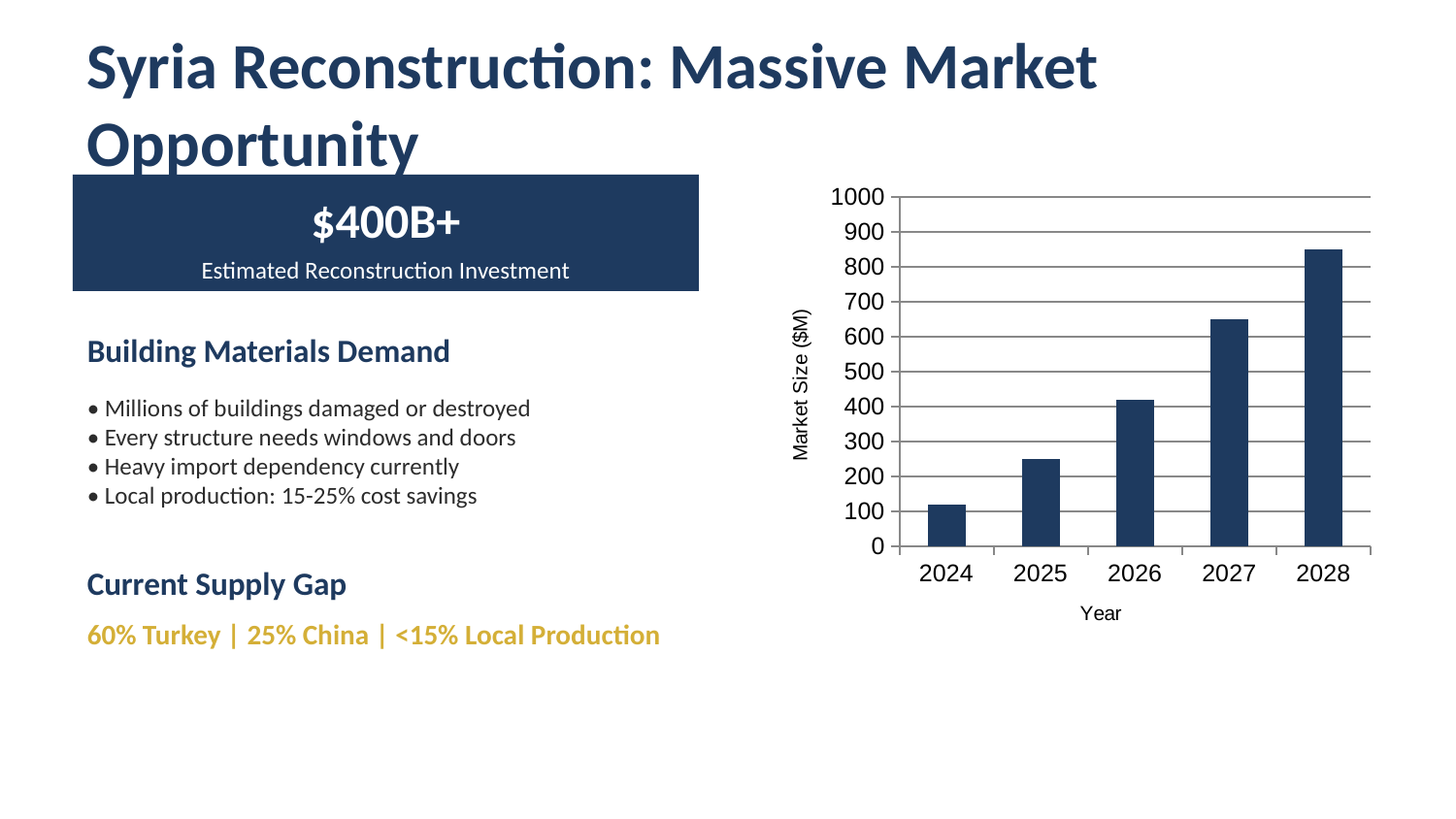
What is the label on the vertical axis of the chart? Market Size ($M) How many years are plotted on the x axis of the chart? 5 Is the market size for 2027 greater or less than 500? greater Is the market size for 2024 greater or less than 200? less Is the market size for 2028 greater or less than 800? greater Which year has the highest market size in the chart? 2028 What kind of chart is shown on the slide? Bar chart Which year has a larger market size, 2025 or 2027? 2027 Which year has the lowest market size in the chart? 2024 Do the market size values rise or fall from 2024 to 2028? Rise